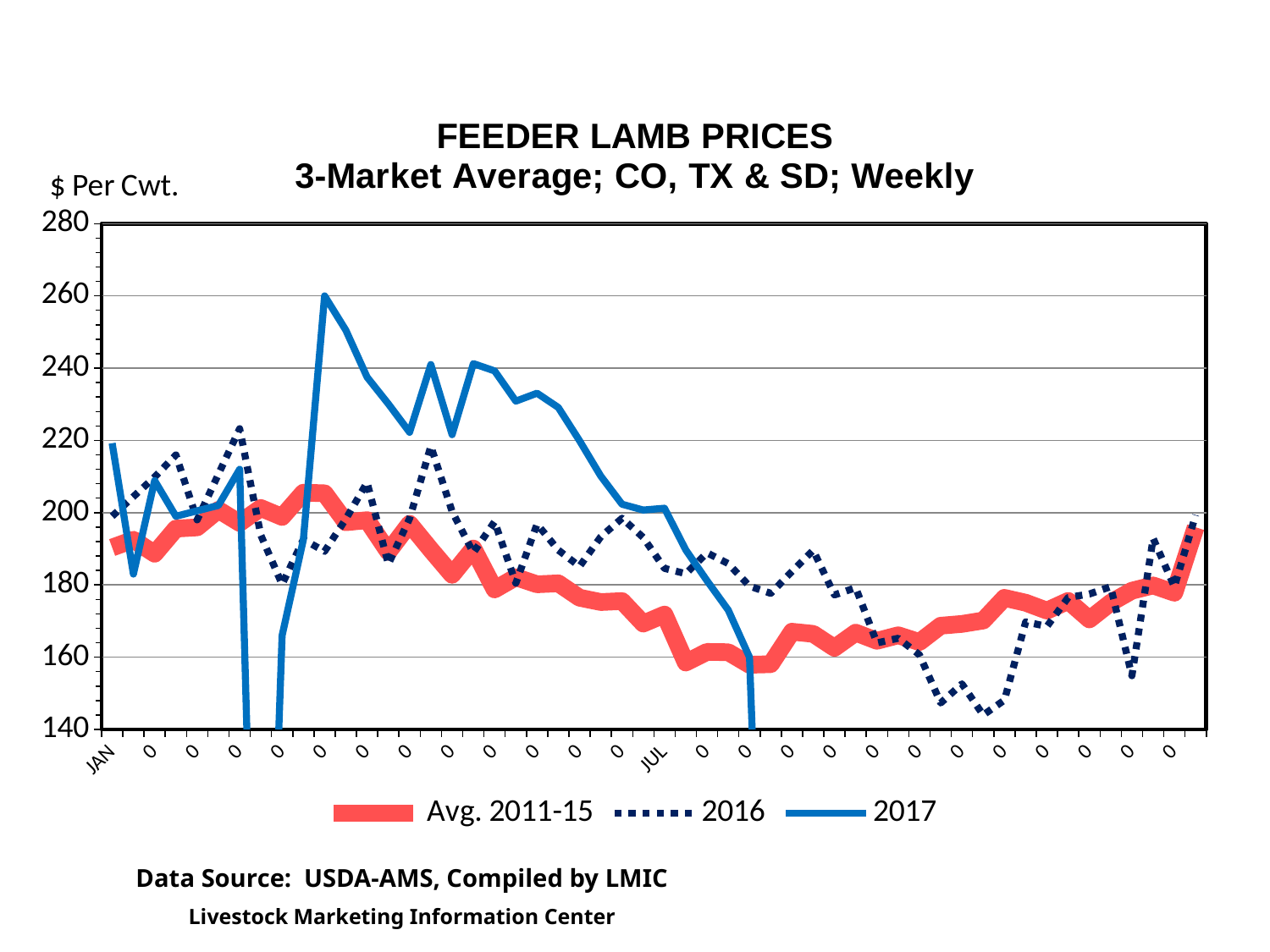
What kind of chart is shown on the slide? line chart Is the peak value of the 2017 series greater or less than 240? greater At JUL, which is larger: the 2017 series or the Avg. 2011-15 series? 2017 Does the 2017 series rise or fall from its peak to JUL? fall Which series reaches the highest value on the chart? 2017 What is the label on the y axis of the chart? $ Per Cwt. How many series does the legend list? 3 Does the Avg. 2011-15 series rise or fall from JUL to the end of the year? rise What are the three series listed in the legend? Avg. 2011-15, 2016, 2017 Is the value of the 2017 series at JAN greater or less than 200? greater Is the value of the Avg. 2011-15 series at JUL greater or less than 180? less